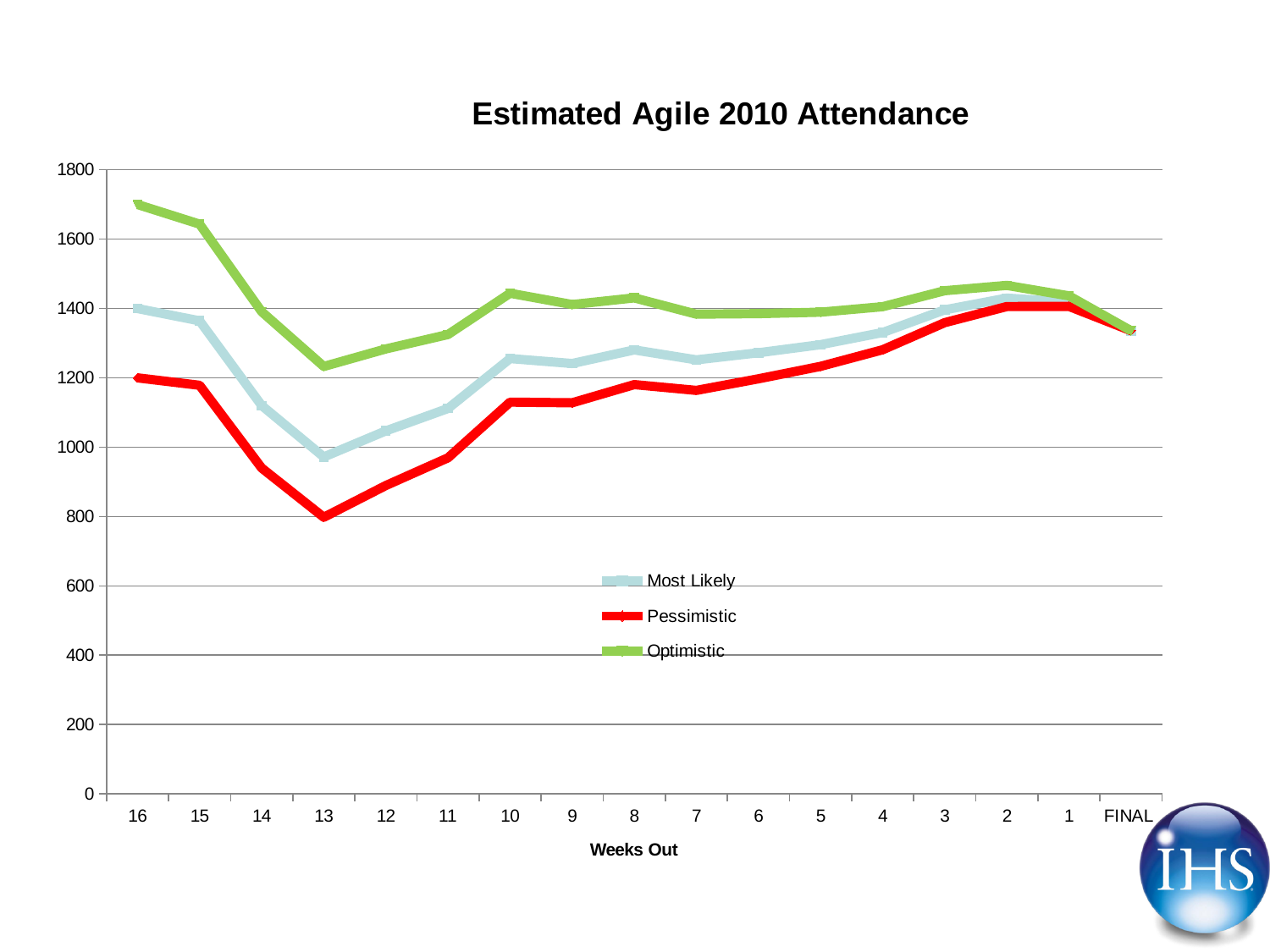
What is the label of the x axis? Weeks Out Is the Pessimistic value at 14 weeks out greater or less than 1000? less How many series does the legend list? 3 What kind of chart is shown on the slide? line chart Is the Optimistic value at 16 weeks out greater or less than 1600? greater What is the title of the chart? Estimated Agile 2010 Attendance How many points are plotted along the x axis for each series? 17 Is the Most Likely value at 13 weeks out greater or less than 1000? less At which point on the x axis is the Optimistic series highest? 16 Which series has the larger value at 16 weeks out, Optimistic or Pessimistic? Optimistic At which point on the x axis is the Pessimistic series lowest? 13